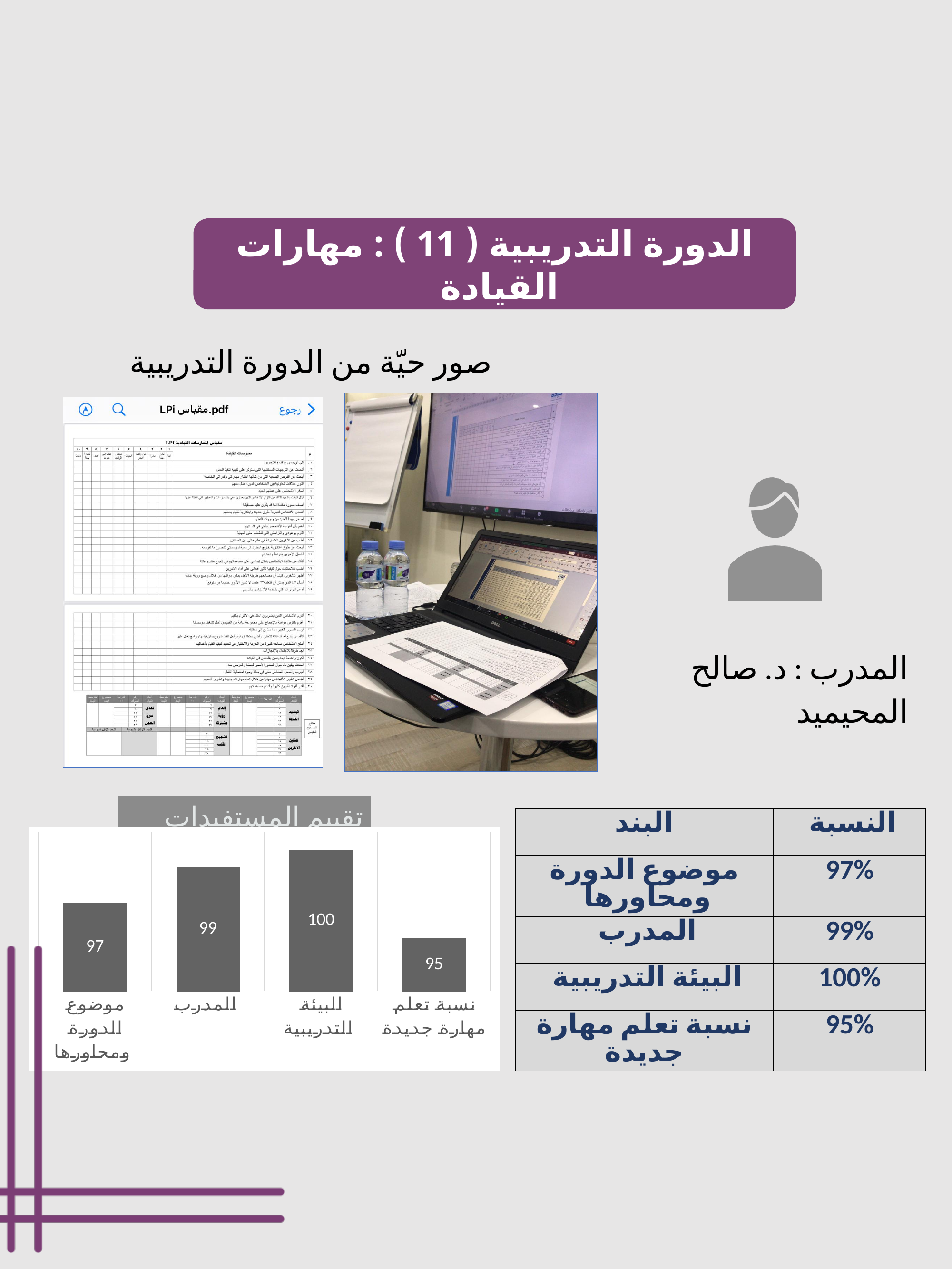
Which category has the highest value in the bar chart? البيئة التدريبية What kind of chart is shown at the bottom left of the slide? Bar chart What value does the bar chart show for موضوع الدورة ومحاورها? 97 What colour are the bars in the bar chart? Grey What value does the bar chart show for المدرب? 99 How many categories are shown in the bar chart? 4 In the bar chart, which is larger: the value for المدرب or the value for موضوع الدورة ومحاورها? المدرب Which category has the lowest value in the bar chart? نسبة تعلم مهارة جديدة What is the difference between the values for المدرب and موضوع الدورة ومحاورها in the bar chart? 2 What value does the bar chart show for نسبة تعلم مهارة جديدة? 95 What value does the bar chart show for البيئة التدريبية? 100 What is the difference between the values for البيئة التدريبية and نسبة تعلم مهارة جديدة in the bar chart? 5